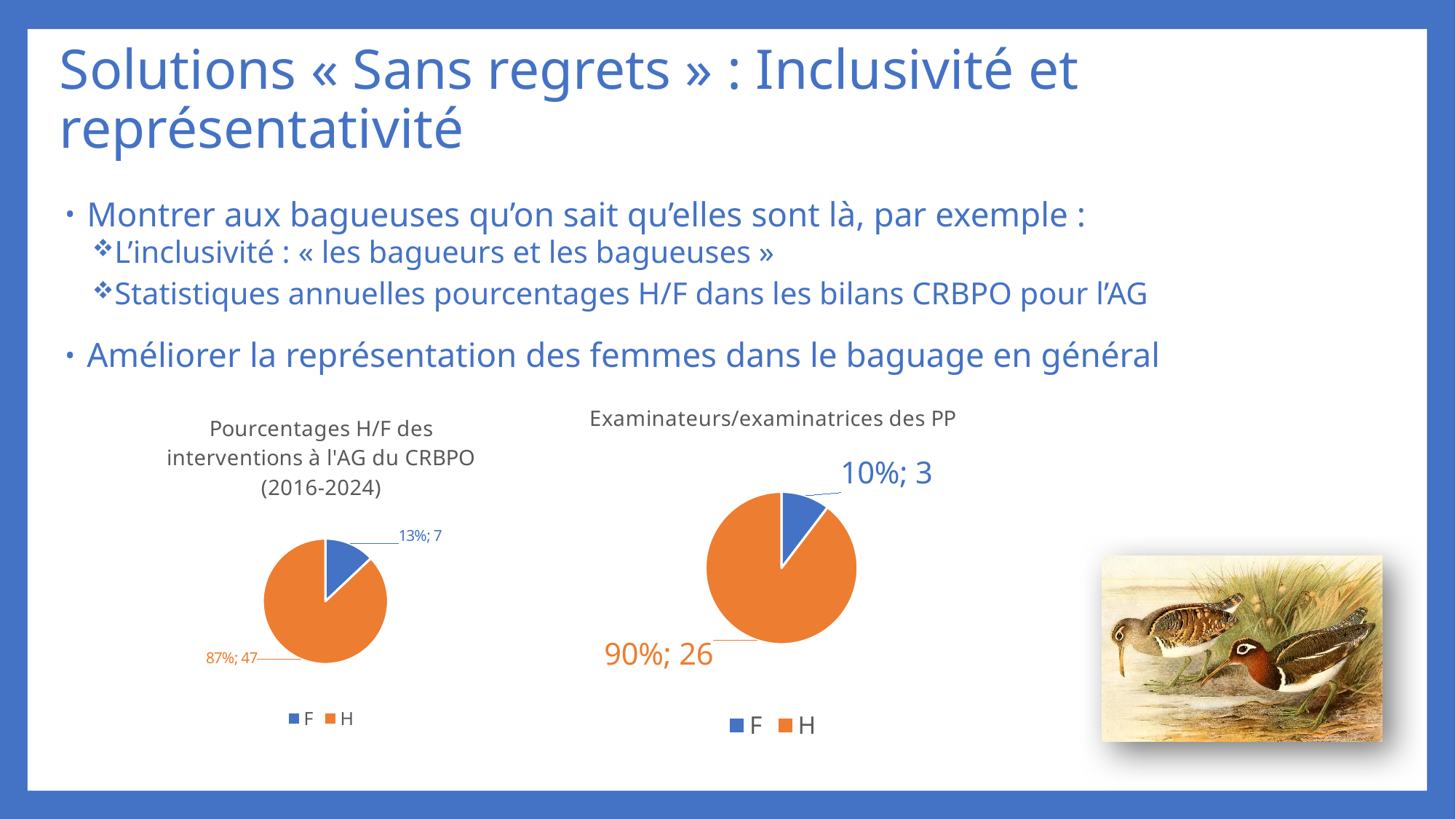
In the chart titled "Pourcentages H/F des interventions à l'AG du CRBPO (2016-2024)", which category has the smallest slice? F In the chart titled "Pourcentages H/F des interventions à l'AG du CRBPO (2016-2024)", what share of the pie does the H slice represent? 87% In the chart titled "Examinateurs/examinatrices des PP", what share of the pie does the F slice represent? 10% In the chart titled "Examinateurs/examinatrices des PP", which category has the largest slice? H In the chart titled "Pourcentages H/F des interventions à l'AG du CRBPO (2016-2024)", what is the data label for the F slice? 13%; 7 How many entries does the legend of the chart titled "Pourcentages H/F des interventions à l'AG du CRBPO (2016-2024)" list? 2 In the chart titled "Examinateurs/examinatrices des PP", what is the data label for the H slice? 90%; 26 In the chart titled "Examinateurs/examinatrices des PP", what is the difference in count between H and F? 23 What kind of chart is the chart titled "Examinateurs/examinatrices des PP"? Pie chart In the chart titled "Examinateurs/examinatrices des PP", what is the data label for the F slice? 10%; 3 In the chart titled "Pourcentages H/F des interventions à l'AG du CRBPO (2016-2024)", what is the total count of F and H combined? 54 In the chart titled "Pourcentages H/F des interventions à l'AG du CRBPO (2016-2024)", what is the data label for the H slice? 87%; 47